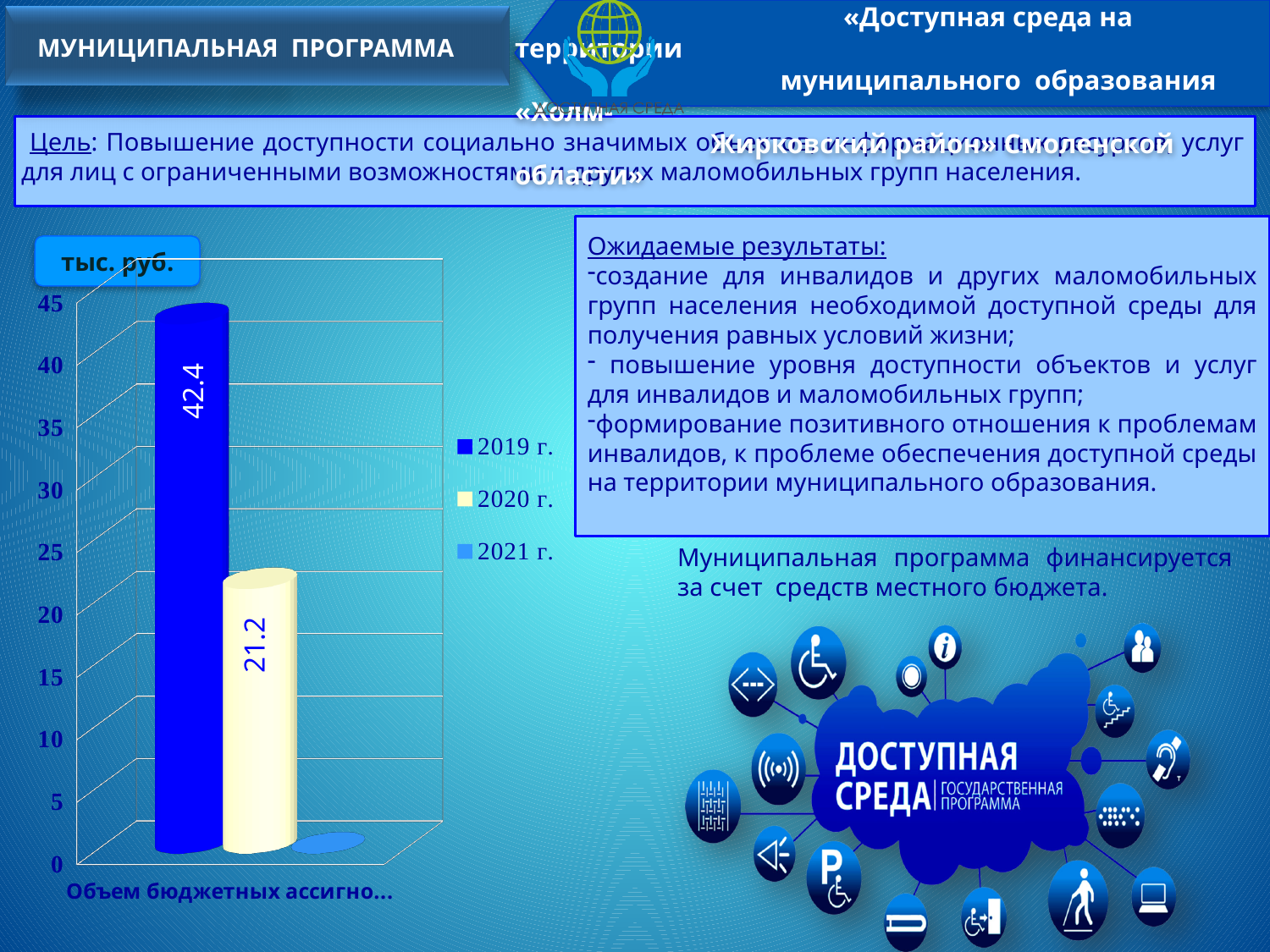
What is the value shown for the 2020 г. series? 21.2 What unit is indicated in the label above the chart? тыс. руб. What is the difference between the 2019 г. value and the 2020 г. value? 21.2 Which series has the highest value in the chart? 2019 г. Is the value for 2019 г. greater or less than 40? greater How many series does the legend list? 3 Which series has the lowest value in the chart? 2021 г. What is the value shown for the 2019 г. series? 42.4 Is the value for 2021 г. greater or less than 5? less What kind of chart is shown on the slide? bar chart Do the values fall or rise from 2019 г. to 2021 г.? fall Which is larger, the value for 2019 г. or the value for 2020 г.? 2019 г.